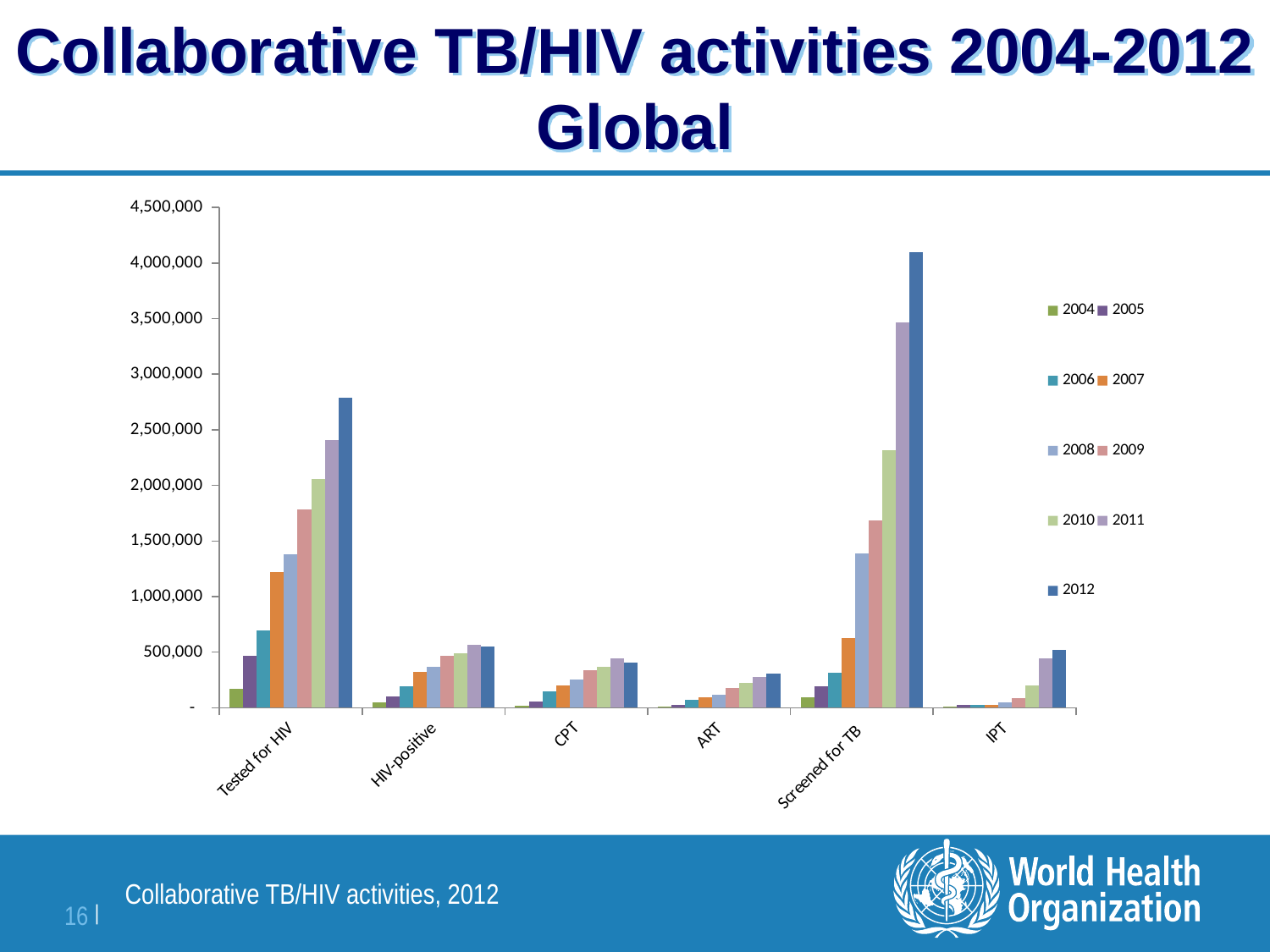
How many series (years) does the legend list? 9 Is the value for Tested for HIV in 2012 greater or less than 2,500,000? greater Which category has the highest value for 2004? Tested for HIV Is the value for Screened for TB in 2012 greater or less than 4,000,000? greater What kind of chart is shown on the slide? bar chart Which category has the tallest bar in the chart? Screened for TB Do the values for Tested for HIV rise or fall from 2004 to 2012? rise Which category has the lowest value for 2012? ART Which is larger in 2012: Screened for TB or Tested for HIV? Screened for TB How many activity categories are shown along the x axis? 6 Is the value for CPT in 2012 greater or less than 500,000? less